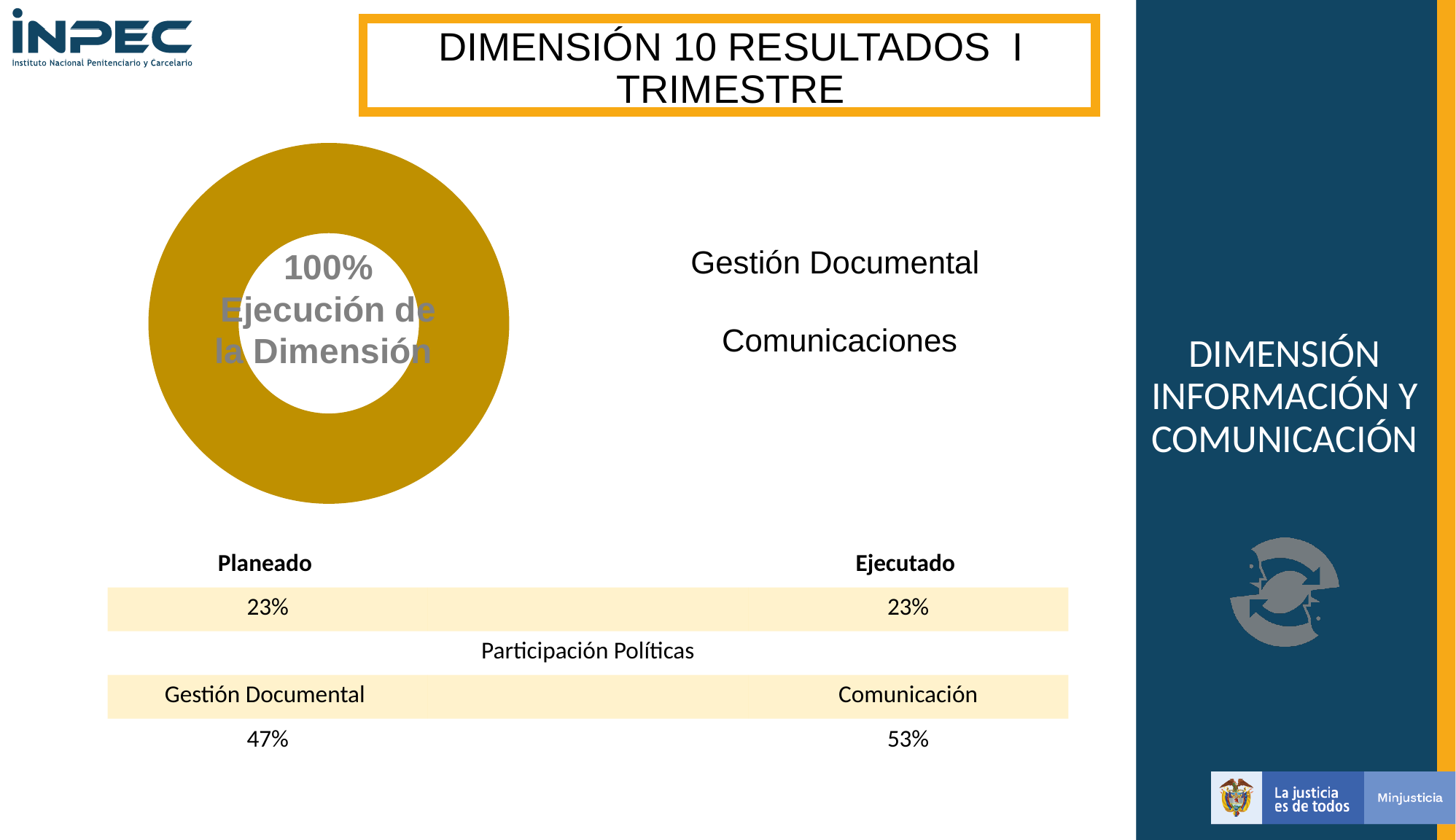
How many slices does the donut chart contain? 1 What label accompanies the 100% value in the centre of the donut chart? Ejecución de la Dimensión Is the value shown in the donut chart greater or less than 50%? greater What colour is the ring of the donut chart? gold What share of the donut chart does the single slice occupy? 100% What value does the donut chart show for Ejecución de la Dimensión? 100% What kind of chart is shown on the left of the slide? donut chart What percentage is printed in the centre of the donut chart? 100%